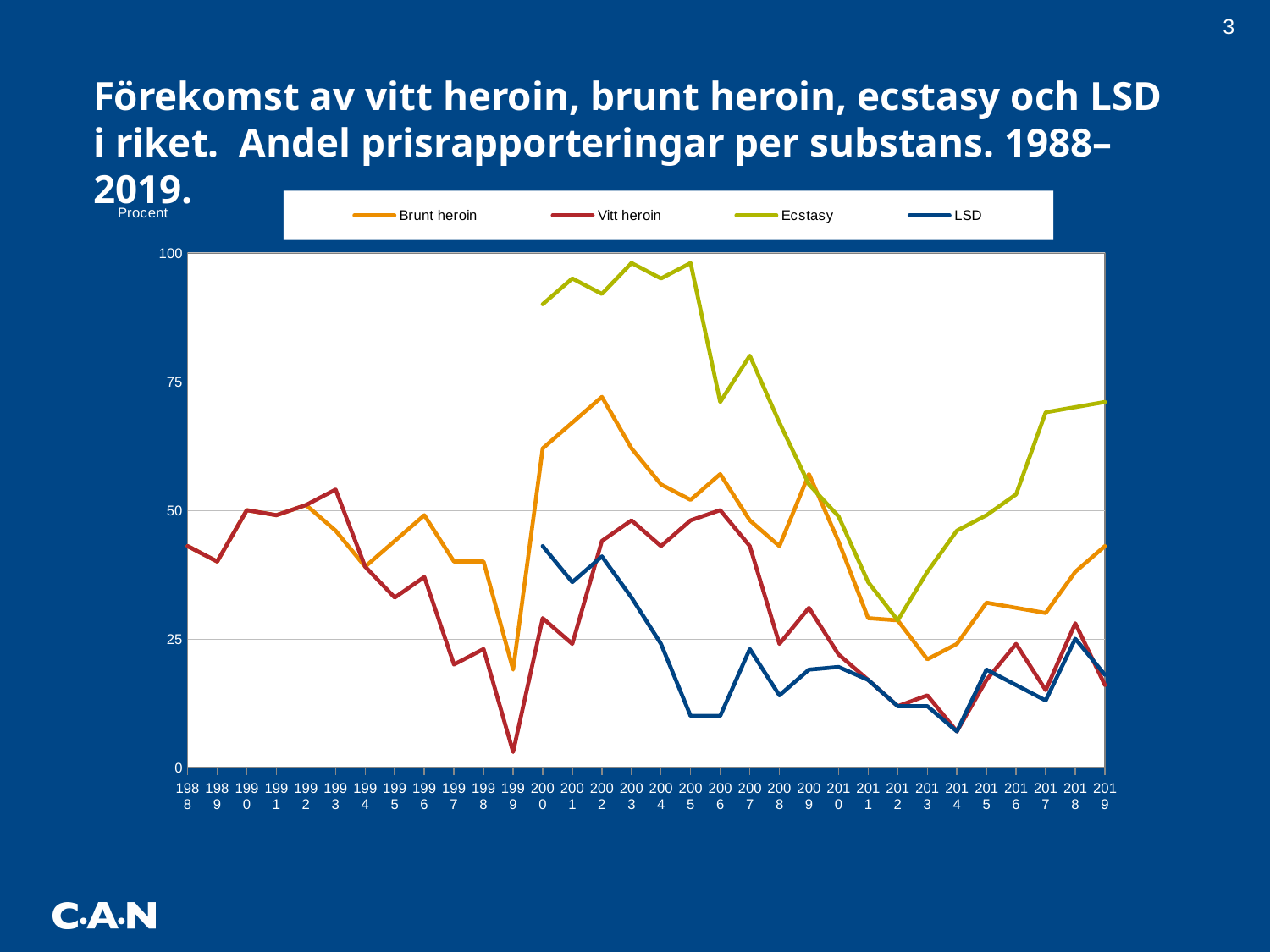
In 2000, which is higher: Brunt heroin or Vitt heroin? Brunt heroin How many series does the legend list? 4 Which series has the highest value in 2005? Ecstasy Does the Ecstasy line rise or fall between 2005 and 2012? Fall Is the value for Vitt heroin in 1999 greater or less than 25? less In which year does Vitt heroin reach its lowest value? 1999 Is the value for LSD in 2005 greater or less than 25? less Is the value for Brunt heroin in 2002 greater or less than 50? greater What kind of chart is shown on the slide? Line chart How many years are shown along the x axis? 32